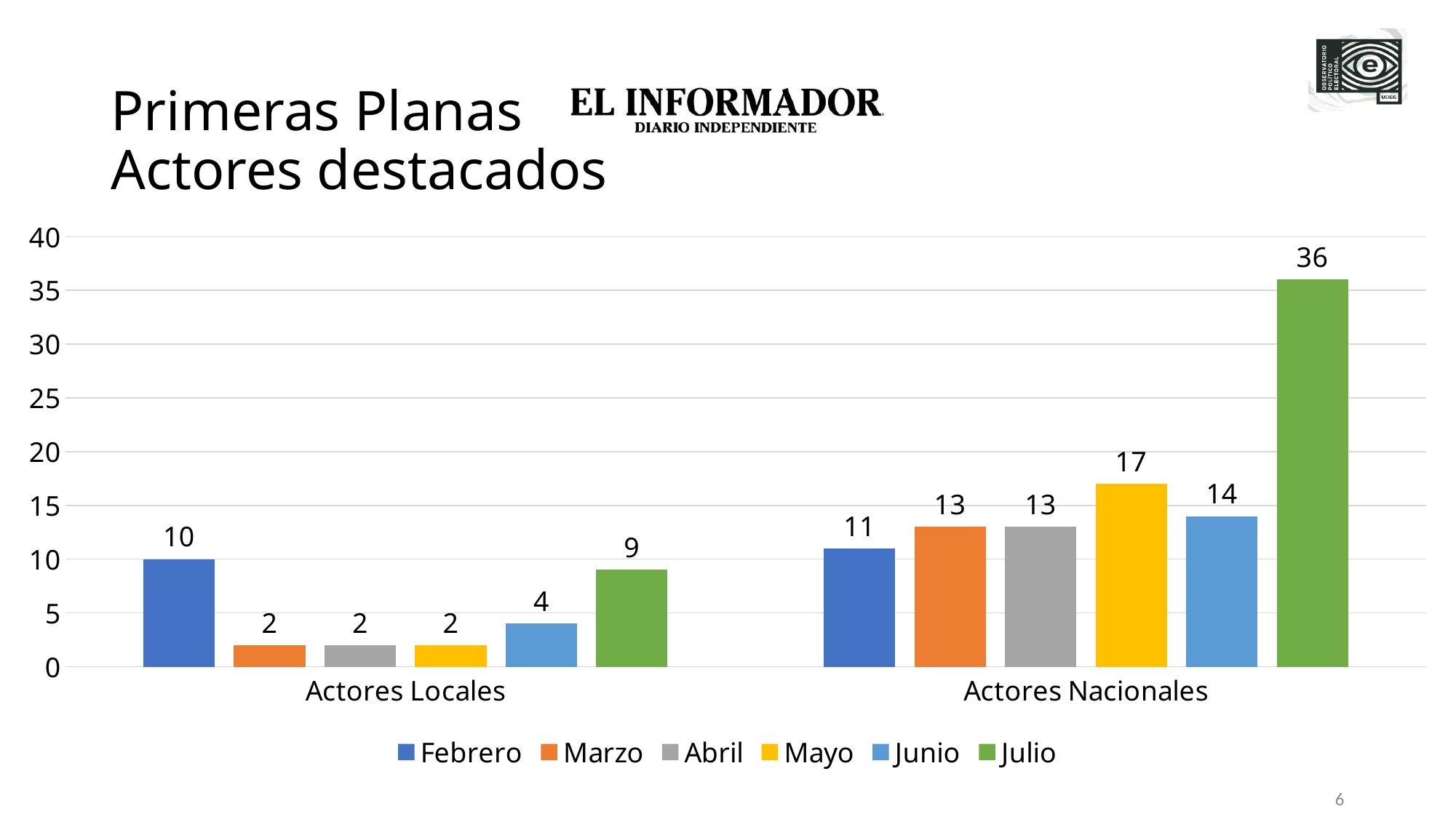
What is the value for Febrero in the Actores Locales category? 10 Which month has the highest value in the Actores Nacionales category? Julio What is the value for Julio in the Actores Nacionales category? 36 Which month has the highest value in the Actores Locales category? Febrero What kind of chart is shown on the slide? Bar chart What is the value for Mayo in the Actores Nacionales category? 17 How many series does the legend list? 6 What is the difference between the Julio values for Actores Nacionales and Actores Locales? 27 Which is larger: the Febrero value for Actores Locales or the Febrero value for Actores Nacionales? Actores Nacionales How many categories are shown on the x axis? 2 Which colour represents Mayo in the legend? Yellow What is the value for Junio in the Actores Locales category? 4